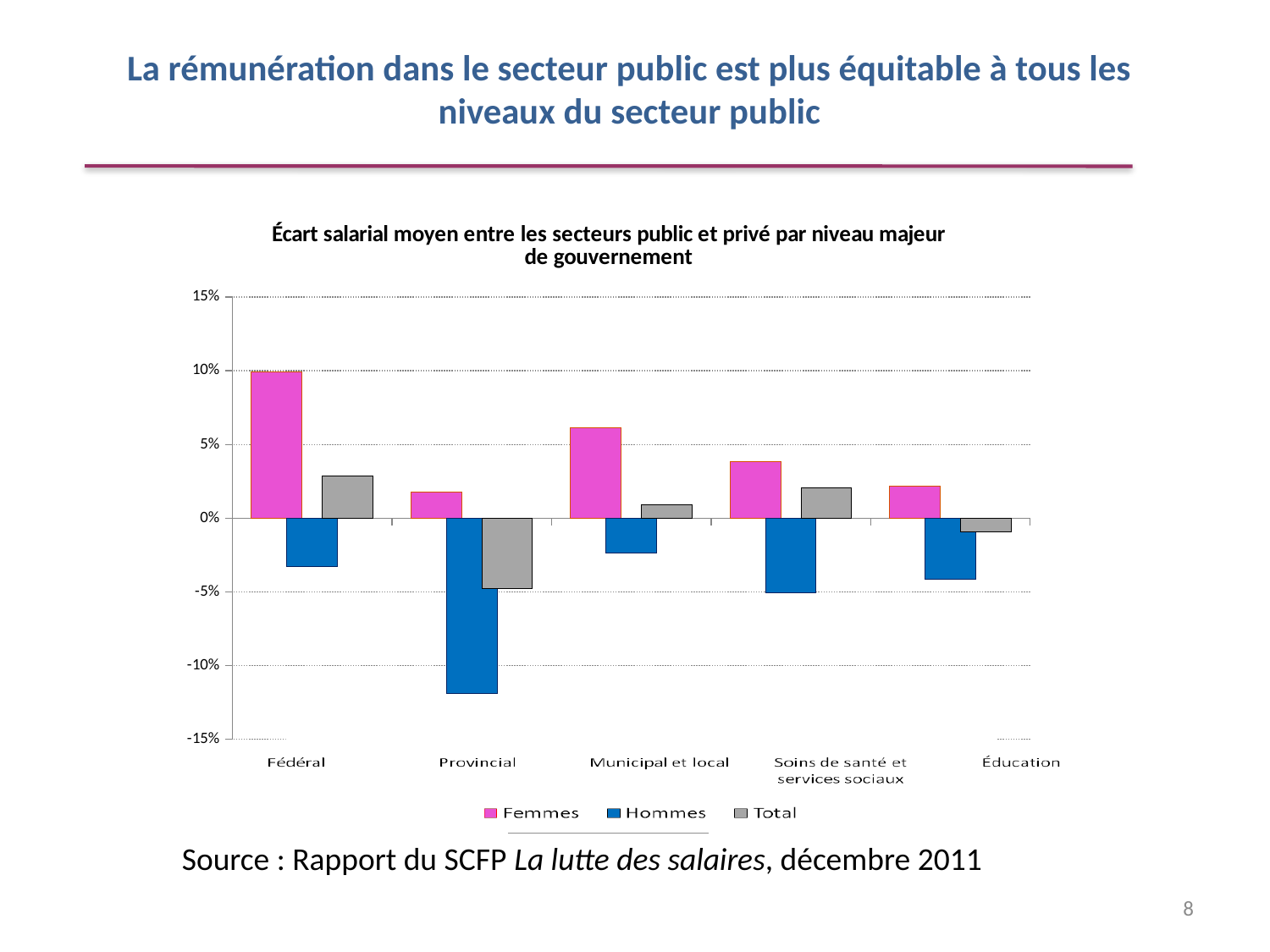
For which category is the Hommes value lowest? Provincial How many series does the legend list? 3 Is the Femmes value for Municipal et local greater or less than 5%? greater For which category is the Total value lowest? Provincial Is the Femmes value for Éducation greater or less than 5%? less What kind of chart is shown on the slide? bar chart Which is larger, the Femmes value for Fédéral or the Femmes value for Municipal et local? Fédéral How many government-level categories are shown on the x axis? 5 Is the Hommes value for Fédéral greater or less than -5%? greater Which colour represents the Hommes series in the legend? blue For which category is the Femmes value highest? Fédéral